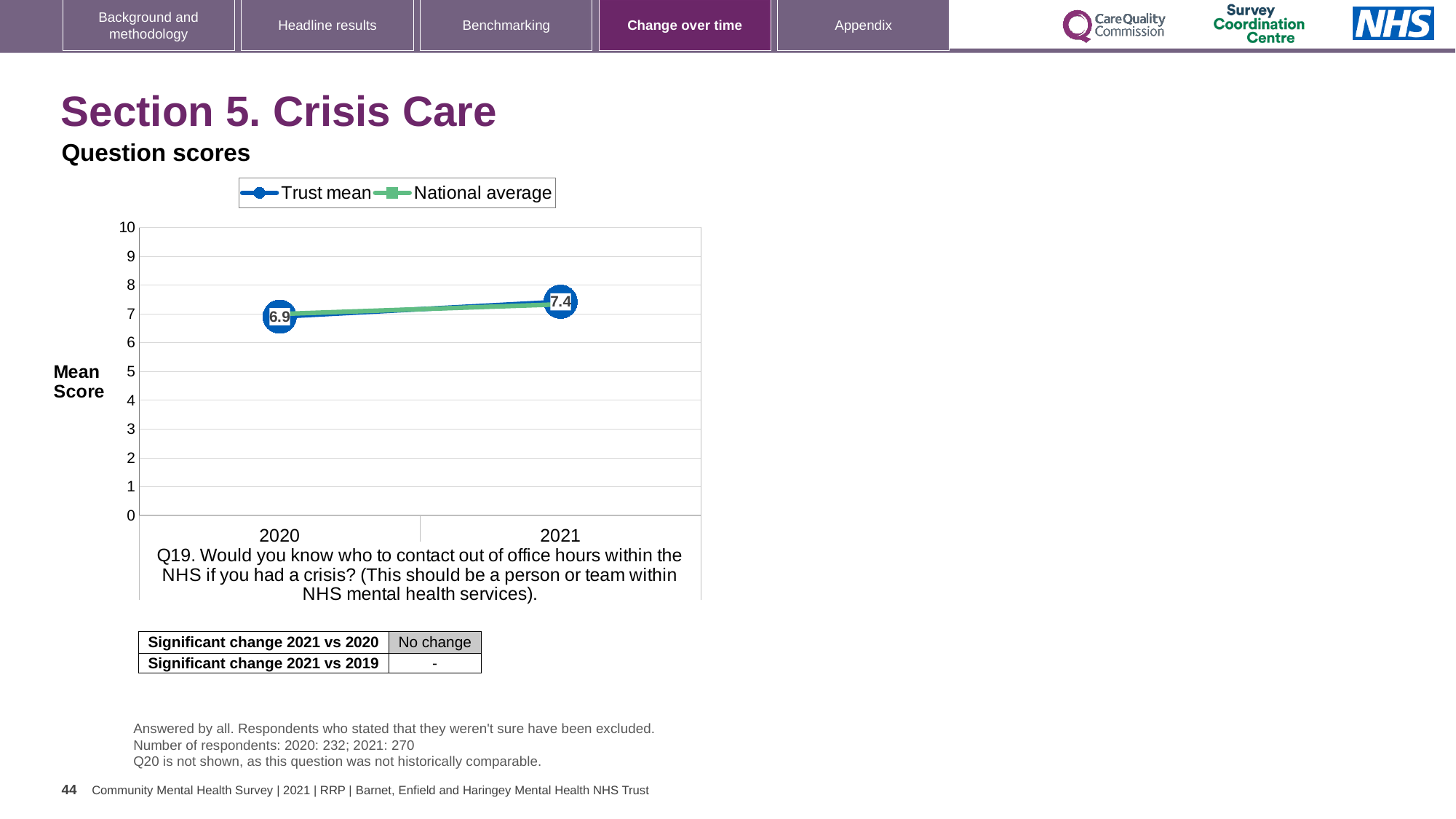
In which year is the Trust mean score higher, 2020 or 2021? 2021 In which year does the Trust mean reach its highest value? 2021 Is the National average value for 2020 greater or less than 5? greater Does the Trust mean rise or fall from 2020 to 2021? rise What is the Trust mean score for 2021? 7.4 How many years are plotted on the x axis? 2 How many series does the legend list? 2 What is the Trust mean score for 2020? 6.9 Is the Trust mean value for 2021 greater or less than 8? less By how much did the Trust mean score change from 2020 to 2021? 0.5 What kind of chart is shown on the slide? line chart What is the label on the y axis of the chart? Mean Score